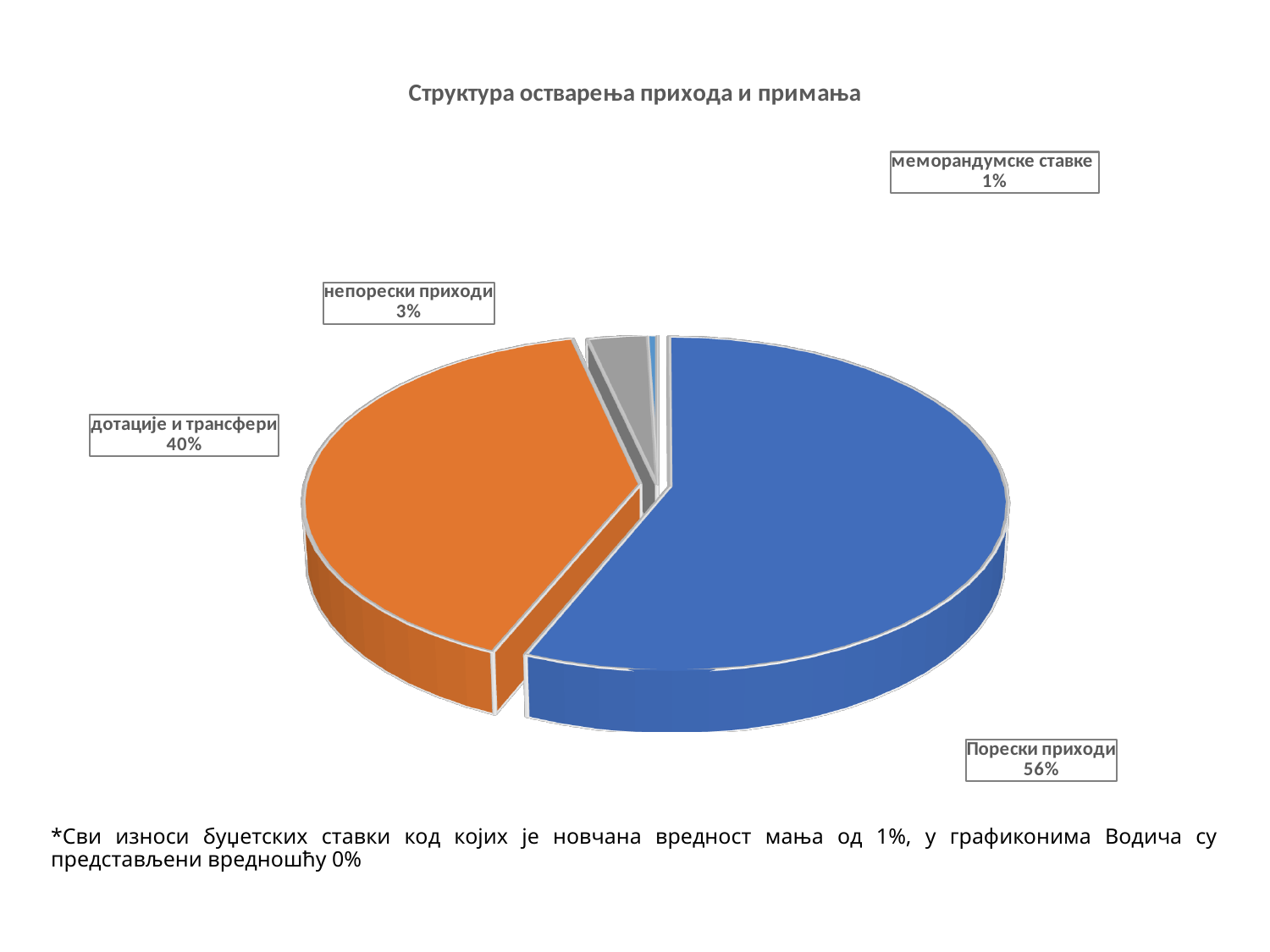
Which category has the largest share of the pie? Порески приходи What colour is the slice for дотације и трансфери? Orange How many categories are shown in the pie chart? 4 Which is larger, the share for непорески приходи or the share for меморандумске ставке? непорески приходи What kind of chart is shown on the slide? Pie chart What is the difference in percentage points between Порески приходи and дотације и трансфери? 16 What is the title of the chart? Структура остварења прихода и примања What share of the pie does Порески приходи hold? 56% What share of the pie does непорески приходи hold? 3% What share of the pie does меморандумске ставке hold? 1% Which category has the smallest share of the pie? меморандумске ставке